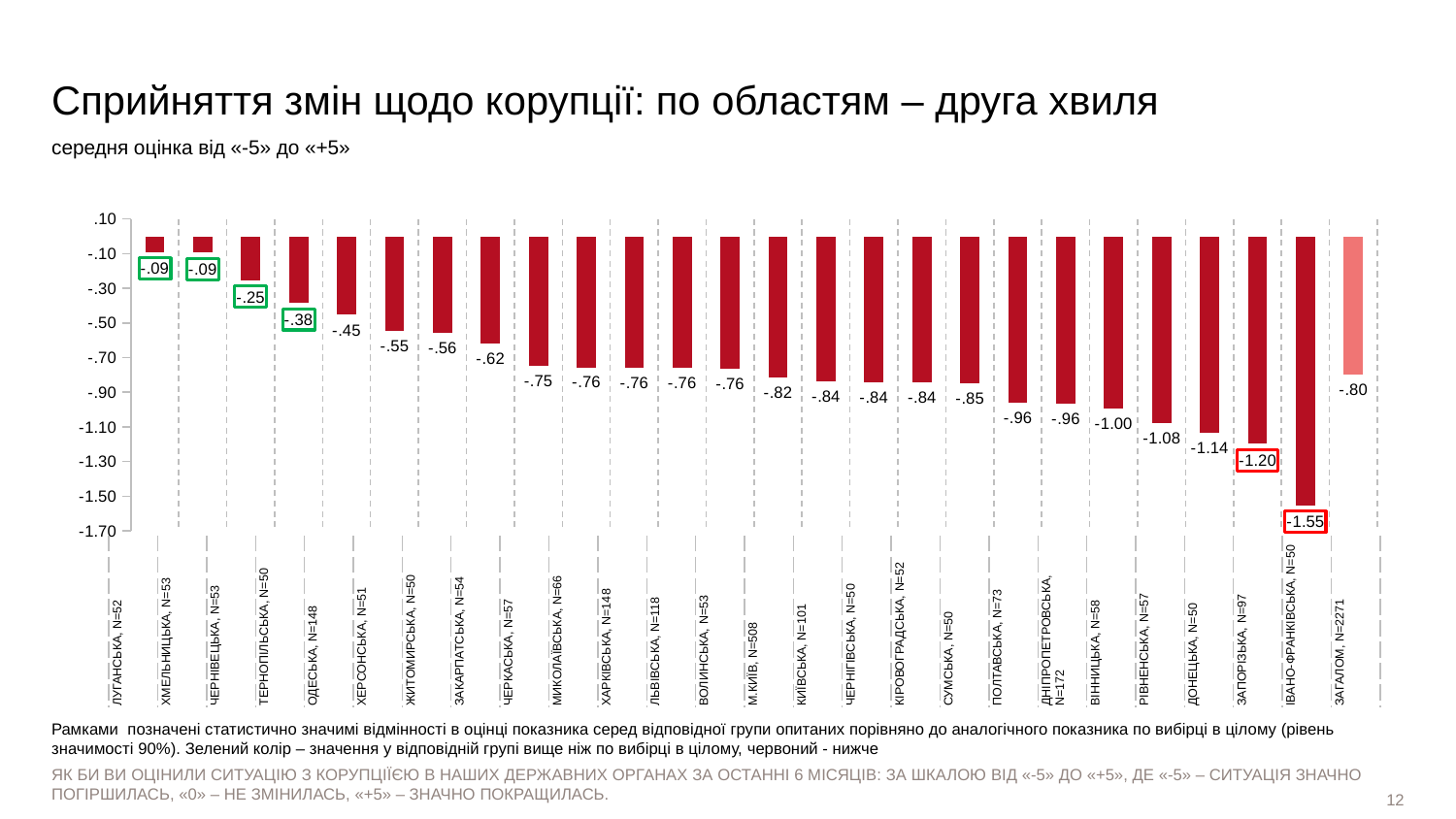
Which category has the lowest value? ІВАНО-ФРАНКІВСЬКА, N=50 What is the difference between the value for ЗАГАЛОМ, N=2271 and the value for ІВАНО-ФРАНКІВСЬКА, N=50? .75 What kind of chart is shown on the slide? bar chart Which bar is drawn in a lighter pink colour than the others? ЗАГАЛОМ, N=2271 What is the value for ВІННИЦЬКА, N=58? -1.00 What is the value for ЗАГАЛОМ, N=2271? -.80 How many bars are plotted in the chart? 26 What is the value for ОДЕСЬКА, N=148? -.45 Which has the larger value, ОДЕСЬКА, N=148 or ДОНЕЦЬКА, N=50? ОДЕСЬКА, N=148 Is the value for ЧЕРКАСЬКА, N=57 greater or less than -.70? less Do the values of the regional bars rise or fall from left to right across the chart (excluding the final ЗАГАЛОМ bar)? fall What is the value for ІВАНО-ФРАНКІВСЬКА, N=50? -1.55